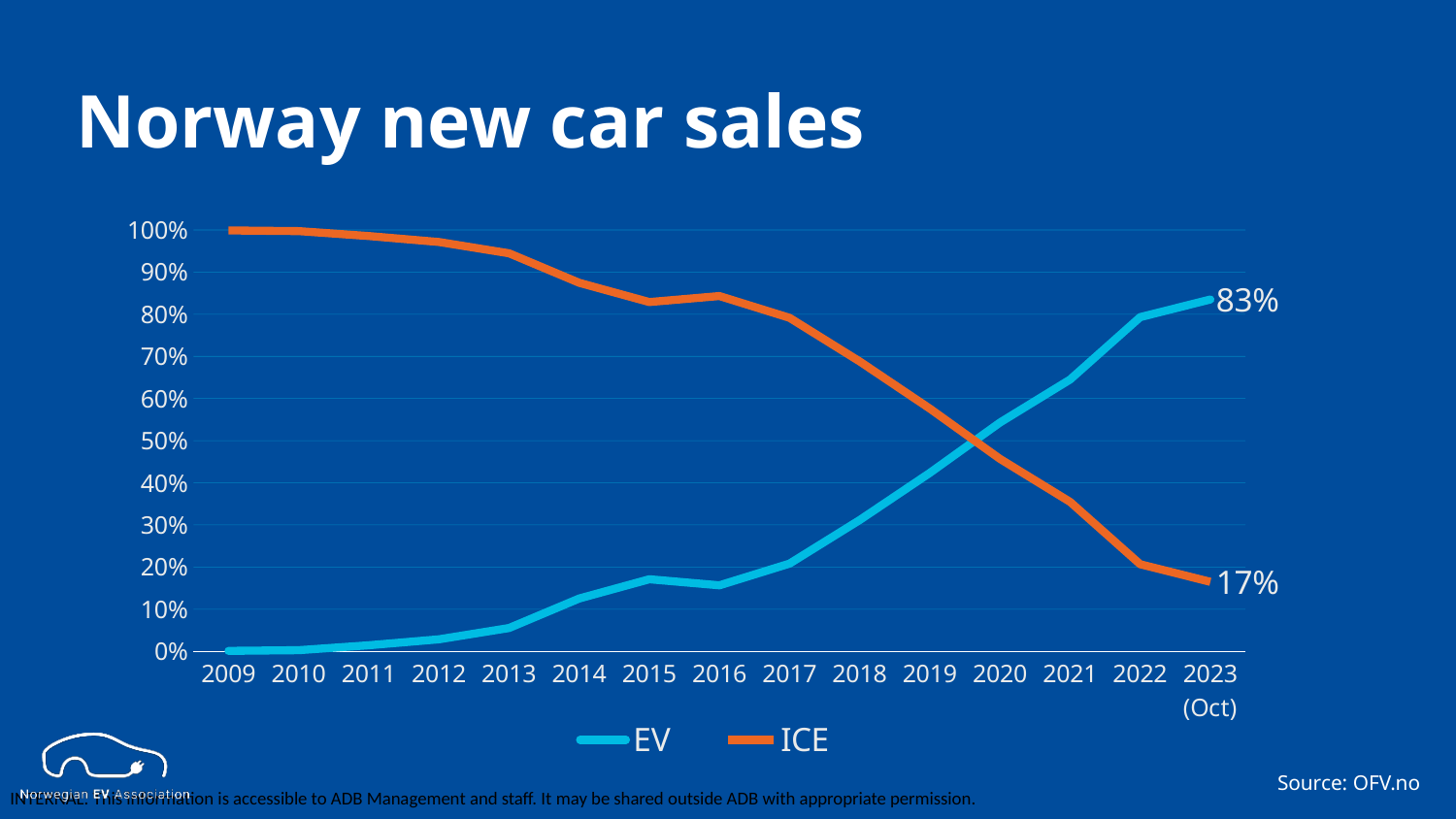
Does the ICE series rise or fall from 2009 to 2023? Falls In 2009, which series has the larger value, EV or ICE? ICE Is the ICE value for 2013 greater or less than 90%? greater In which year does the ICE series reach its lowest value? 2023 (Oct) How many years are shown along the x axis? 15 In 2023 (Oct), how many percentage points higher is the EV share than the ICE share? 66 percentage points How many series does the legend list? 2 Does the EV series rise or fall from 2009 to 2023? Rises What is the ICE share of Norway new car sales in 2023 (Oct)? 17% What kind of chart is shown on the slide? Line chart Is the EV value for 2009 greater or less than 10%? less What is the EV share of Norway new car sales in 2023 (Oct)? 83%